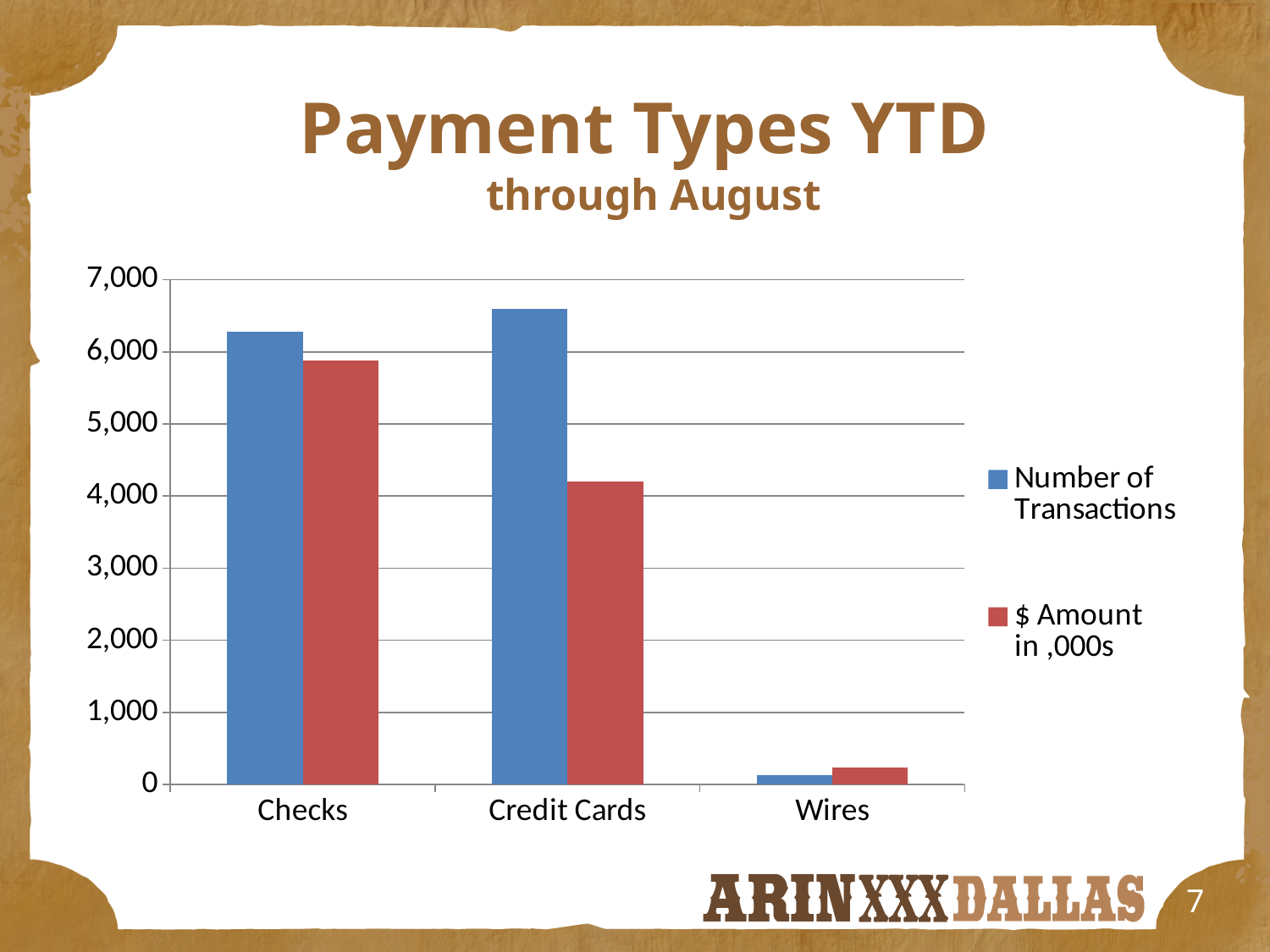
How many series does the legend list? 2 Is the Number of Transactions for Checks greater or less than 6,000? greater For Credit Cards, which is larger: Number of Transactions or $ Amount in ,000s? Number of Transactions What kind of chart is shown on the slide? bar chart What colour are the bars for the $ Amount in ,000s series? red Is the $ Amount in ,000s for Credit Cards greater or less than 5,000? less How many payment type categories are shown on the x axis? 3 Which payment type has the lowest $ Amount in ,000s? Wires Which payment type has the highest Number of Transactions? Credit Cards Which payment type has the lowest Number of Transactions? Wires Is the Number of Transactions for Wires greater or less than 1,000? less Which payment type has the highest $ Amount in ,000s? Checks